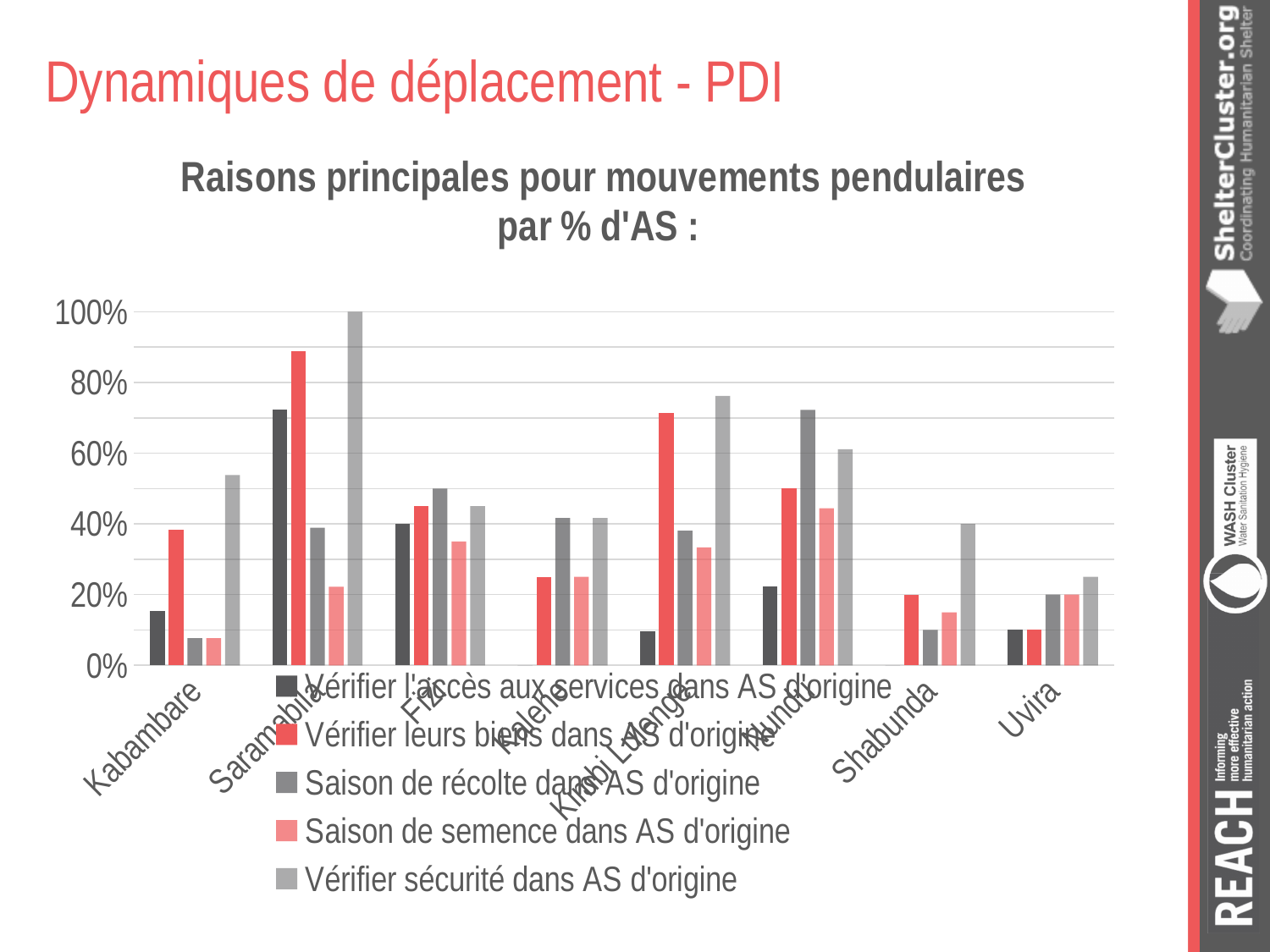
Which is larger: 'Vérifier leurs biens dans AS d'origine' in Saramabila or 'Saison de récolte dans AS d'origine' in Nundu? Vérifier leurs biens dans AS d'origine in Saramabila In Kimbi Lulenga, which series has the lowest value? Vérifier l'accès aux services dans AS d'origine How many categories (zones) are shown along the x axis of the chart? 8 What kind of chart is shown on the slide? bar chart Is the value for 'Vérifier leurs biens dans AS d'origine' in Kimbi Lulenga greater or less than 60%? greater Is the value for 'Vérifier leurs biens dans AS d'origine' in Kabambare greater or less than 20%? greater What is the title of the chart? Raisons principales pour mouvements pendulaires par % d'AS : In Kabambare, which is larger: 'Vérifier sécurité dans AS d'origine' or 'Vérifier leurs biens dans AS d'origine'? Vérifier sécurité dans AS d'origine What is the value for 'Vérifier sécurité dans AS d'origine' in Saramabila? 100% How many series does the chart's legend list? 5 Is the value for 'Vérifier l'accès aux services dans AS d'origine' in Uvira greater or less than 20%? less Which category has the tallest bar in the chart? Saramabila